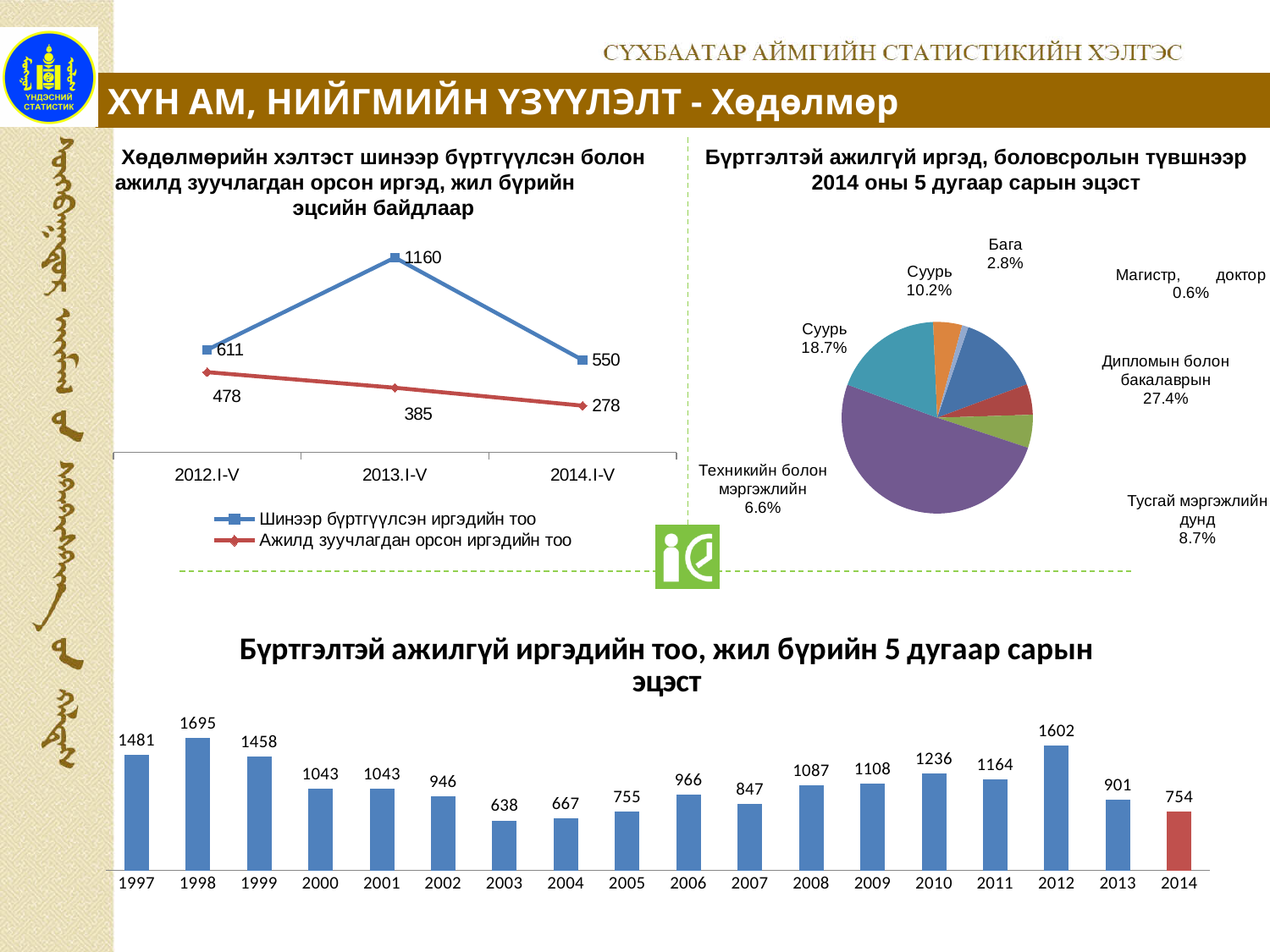
In the bar chart at the bottom, what is the value for 2012? 1602 In the bar chart at the bottom, which year has the highest value? 1998 In the line chart at the top left, does the Ажилд зуучлагдан орсон иргэдийн тоо series rise or fall from 2012.I-V to 2014.I-V? fall In the pie chart at the top right, what share is Магистр, доктор? 0.6% In the line chart at the top left, how many series does the legend list? 2 In the pie chart at the top right, what share is Техникийн болон мэргэжлийн? 6.6% In the pie chart at the top right, what share is Дипломын болон бакалаврын? 27.4% In the line chart at the top left, what is the value for Ажилд зуучлагдан орсон иргэдийн тоо in 2014.I-V? 278 In the bar chart at the bottom, how many years are shown? 18 In the line chart at the top left, what is the value for Шинээр бүртгүүлсэн иргэдийн тоо in 2013.I-V? 1160 In the line chart at the top left, what is the difference between the two series in 2012.I-V? 133 In the bar chart at the bottom, which year has the lowest value? 2003